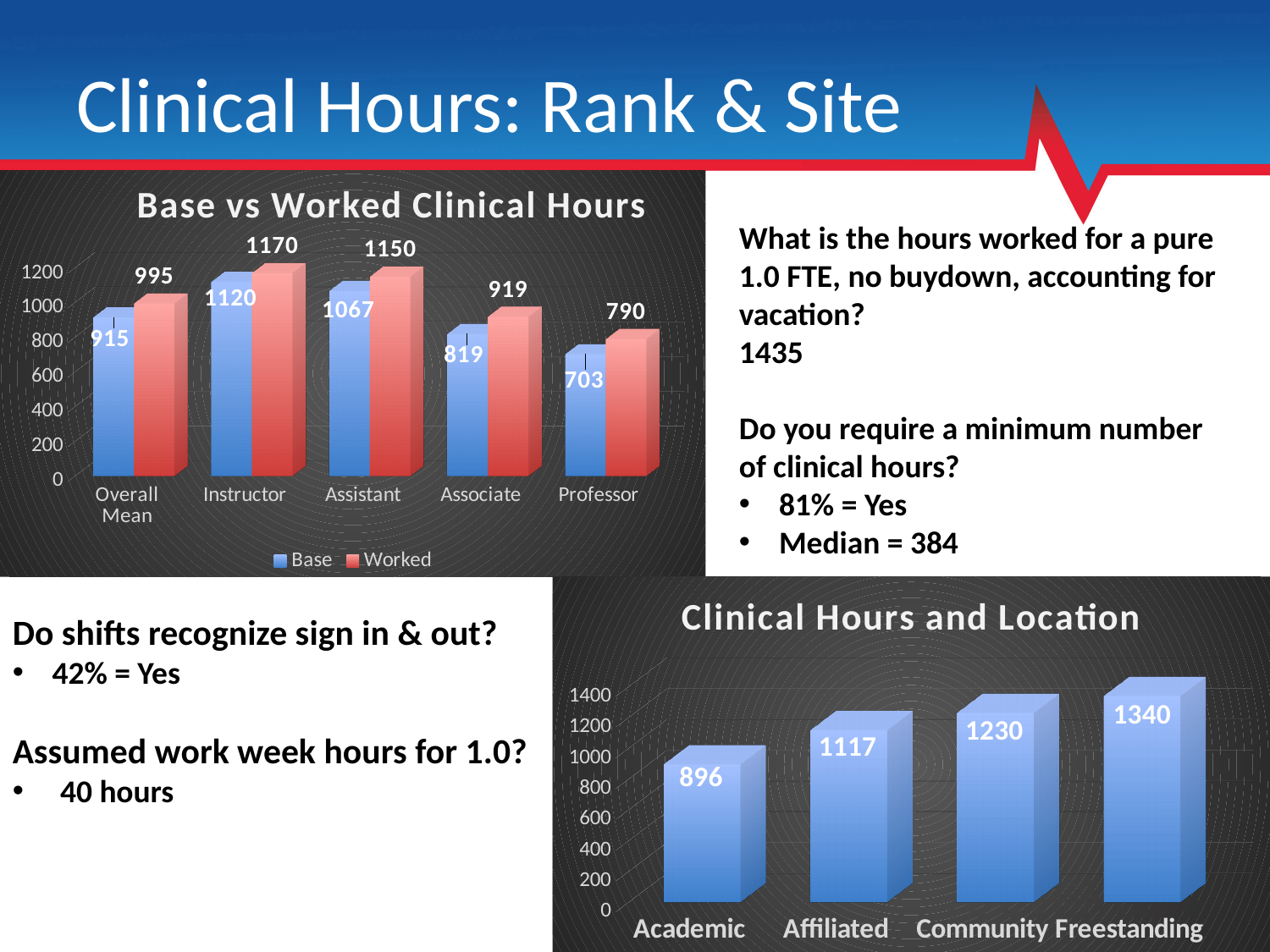
In the 'Base vs Worked Clinical Hours' chart, which category has the lowest Base value? Professor In the 'Clinical Hours and Location' chart, do the values rise or fall from Academic to Freestanding? rise How many categories are shown on the x axis of the 'Base vs Worked Clinical Hours' chart? 5 In the 'Clinical Hours and Location' chart, what is the value for Community? 1230 What kind of chart is the 'Clinical Hours and Location' chart? bar chart In the 'Base vs Worked Clinical Hours' chart, which category has the highest Worked value? Instructor In the 'Base vs Worked Clinical Hours' chart, is the Base value for Assistant larger or the Worked value for Professor? Base value for Assistant In the 'Base vs Worked Clinical Hours' chart, what is the difference between the Worked and Base values for Overall Mean? 80 In the 'Clinical Hours and Location' chart, which location has the highest value? Freestanding How many series does the legend of the 'Base vs Worked Clinical Hours' chart list? 2 In the 'Base vs Worked Clinical Hours' chart, what is the Base value for Instructor? 1120 In the 'Base vs Worked Clinical Hours' chart, what is the Worked value for Associate? 919